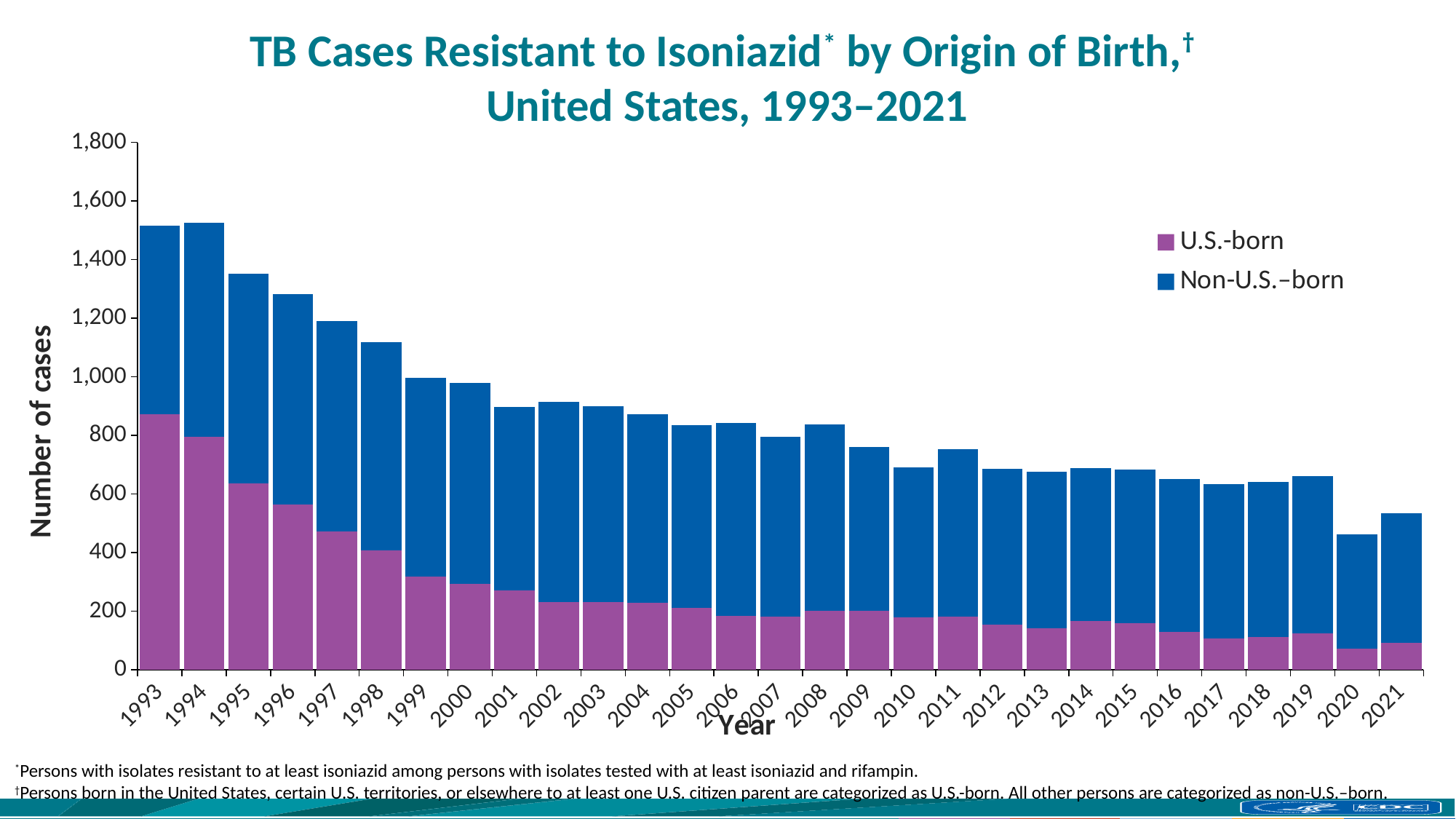
What colour represents U.S.-born cases in the chart? Purple How many series does the legend list? 2 What kind of chart is shown on the slide? Stacked bar chart Which year has the larger total number of cases, 2019 or 2020? 2019 Is the total number of cases for 1993 greater or less than 1,400? greater Is the number of U.S.-born cases for 1995 greater or less than 400? greater Overall, do the total number of cases rise or fall from 1993 to 2021? fall Which year has the highest number of U.S.-born cases? 1993 Is the total number of cases for 2020 greater or less than 600? less How many years are shown along the x axis? 29 Which year has the lowest total number of cases? 2020